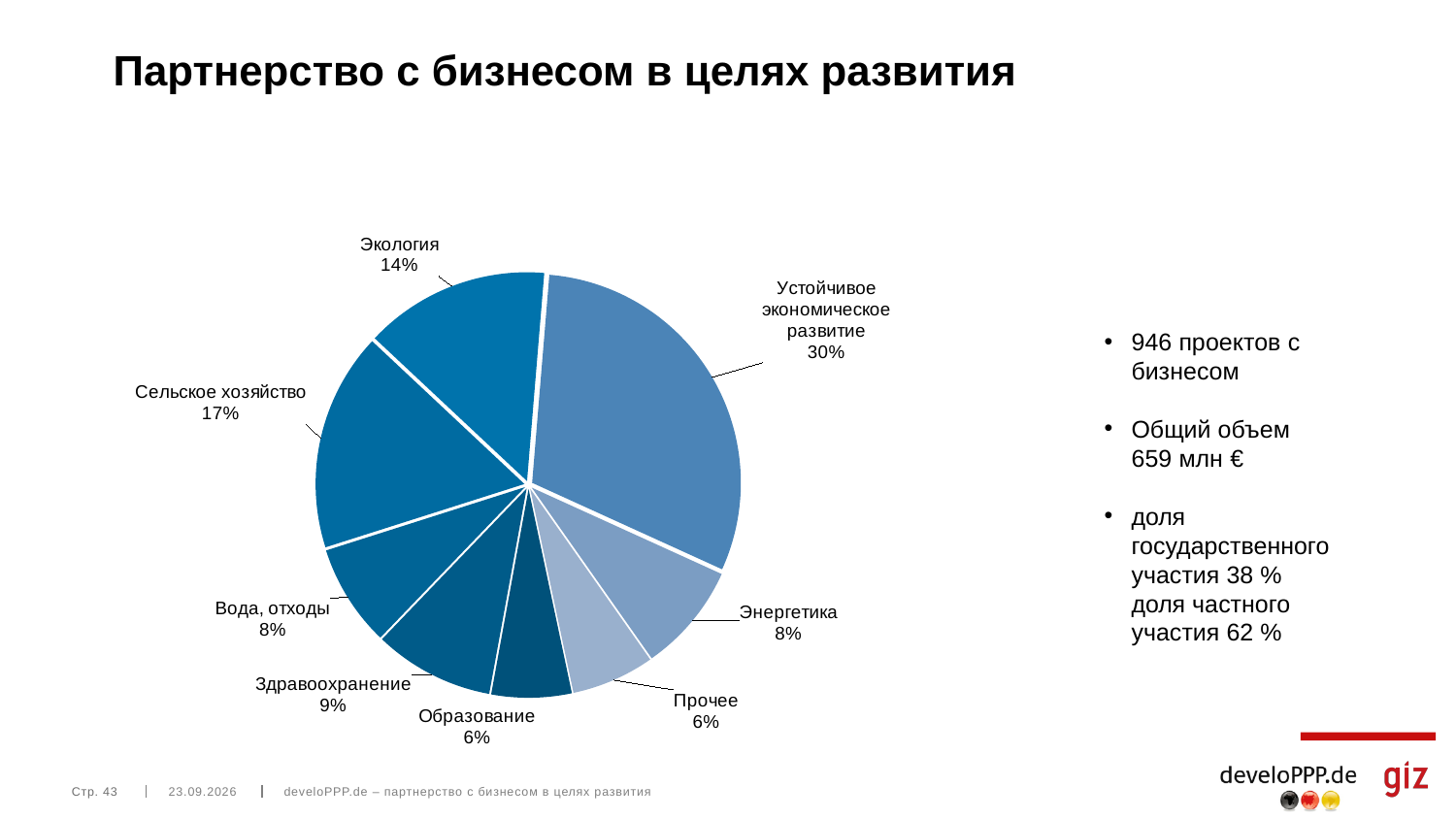
What is the difference in percentage points between "Устойчивое экономическое развитие" and "Энергетика"? 22 percentage points What is the title of the slide containing the pie chart? Партнерство с бизнесом в целях развития Which category has the largest slice of the pie? Устойчивое экономическое развитие What is the difference in percentage points between "Сельское хозяйство" and "Экология"? 3 percentage points What share of the pie does "Сельское хозяйство" have? 17% What share of the pie does "Здравоохранение" have? 9% What share of the pie does "Устойчивое экономическое развитие" have? 30% Which is larger, the share for "Здравоохранение" or the share for "Образование"? Здравоохранение What share of the pie does "Энергетика" have? 8% What share of the pie does "Экология" have? 14% What type of chart is shown on the slide? Pie chart How many categories (slices) does the pie chart have? 8